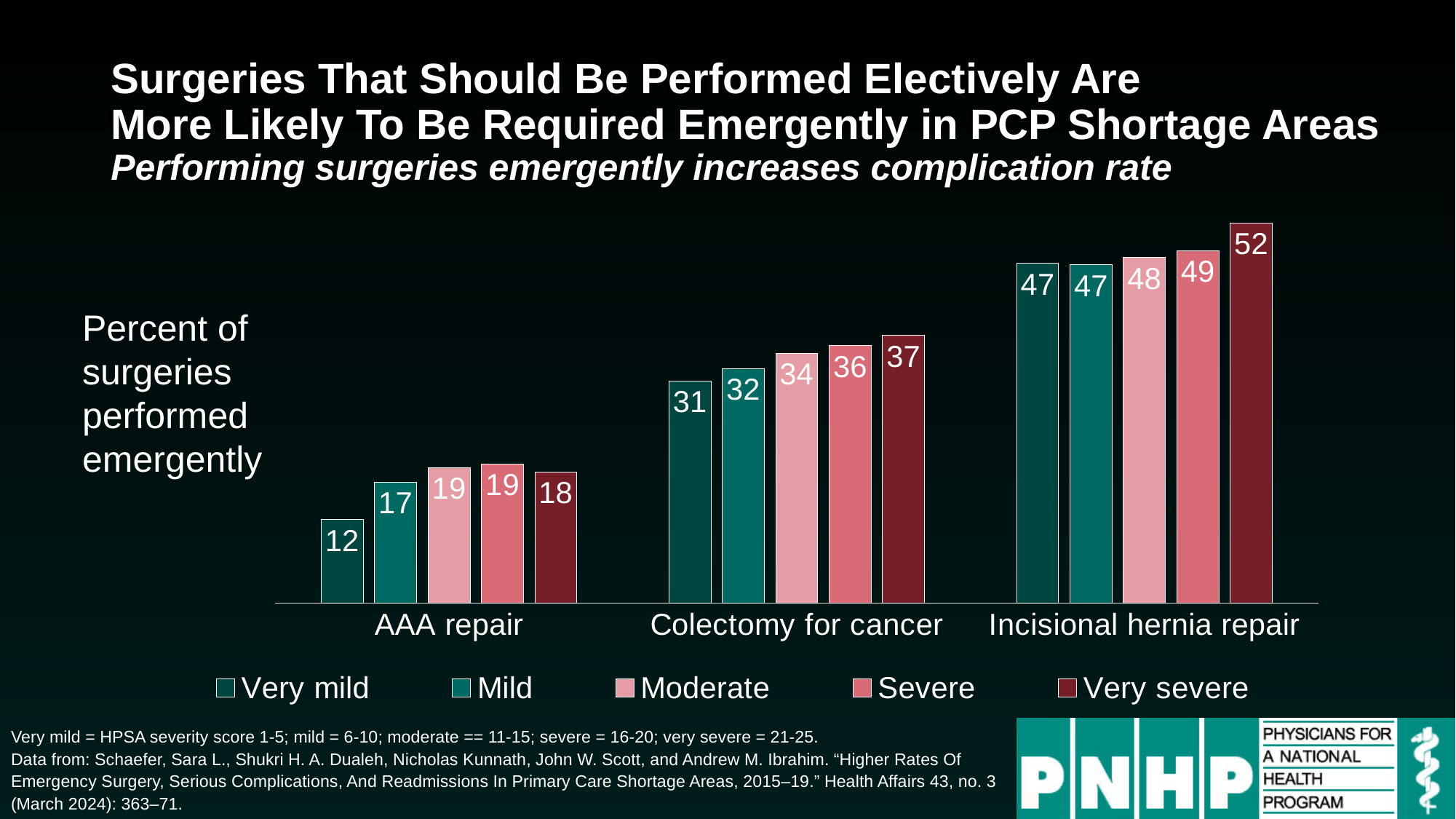
What is the difference between the Severe and Very mild values for AAA repair? 7 Which severity level has the lowest value in the AAA repair group? Very mild How many series does the legend list? 5 What is the value for Very mild in the AAA repair group? 12 What is the value for Moderate in the Colectomy for cancer group? 34 What is the difference between the Very severe and Very mild values for Incisional hernia repair? 5 How many surgery categories are shown on the x axis? 3 Which is larger: the Mild value for Colectomy for cancer or the Very severe value for AAA repair? Mild value for Colectomy for cancer What is the value for Very severe in the Incisional hernia repair group? 52 What is the label of the vertical axis? Percent of surgeries performed emergently Which severity level has the highest value in the Colectomy for cancer group? Very severe What kind of chart is shown on the slide? Bar chart